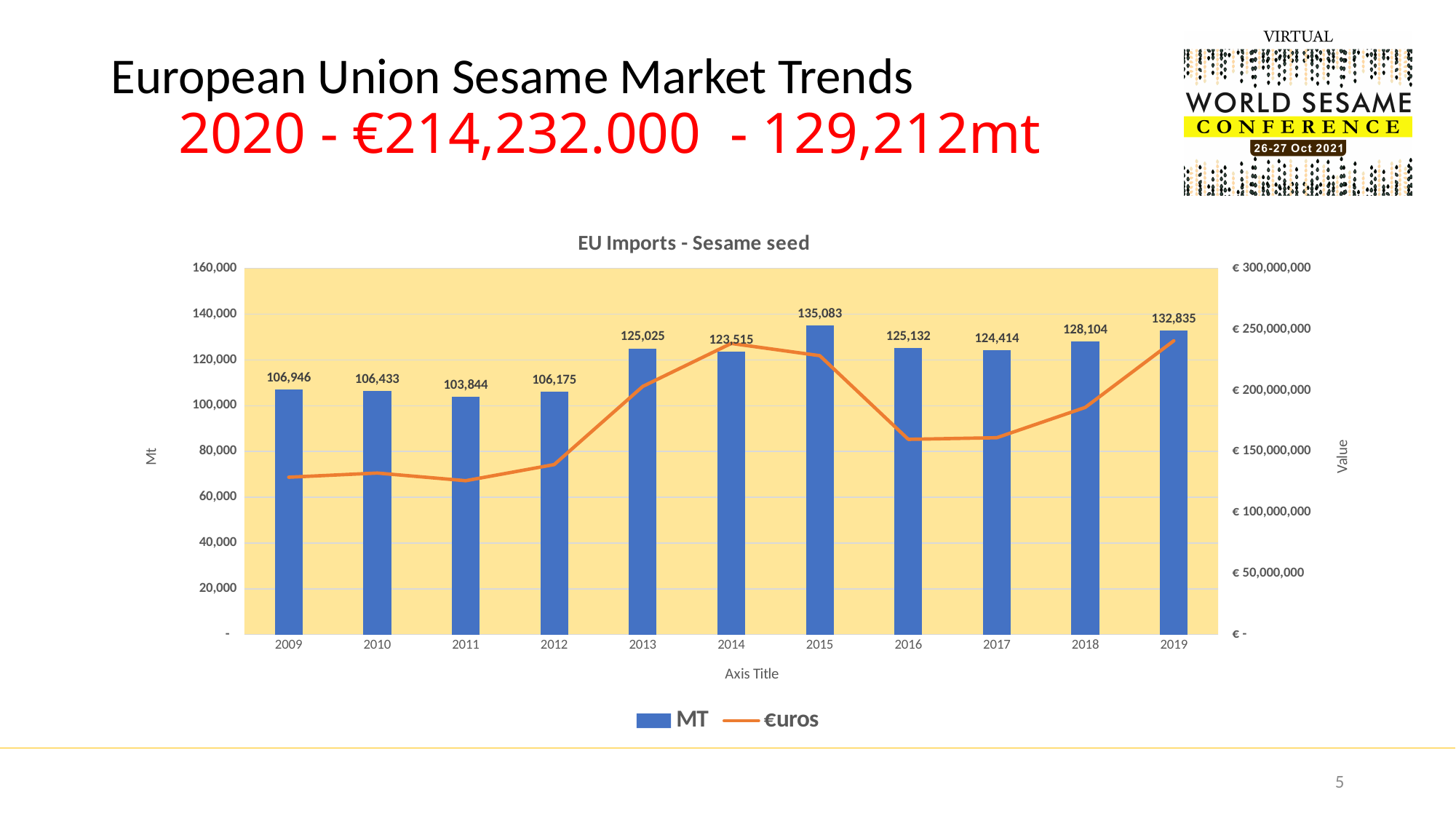
What is the MT value for 2011? 103,844 How many series does the legend list? 2 Is the €uros value for 2009 greater or less than € 150,000,000? less Which year has the highest MT value? 2015 How many years are shown on the x axis of the chart? 11 What is the difference in MT between 2019 and 2018? 4,731 Which year has the lowest MT value? 2011 What is the MT value for 2019? 132,835 Is the €uros value for 2014 greater or less than € 200,000,000? greater What is the MT value for 2015 in the EU Imports - Sesame seed chart? 135,083 Which year has the larger MT value, 2013 or 2016? 2016 What is the title of the chart? EU Imports - Sesame seed